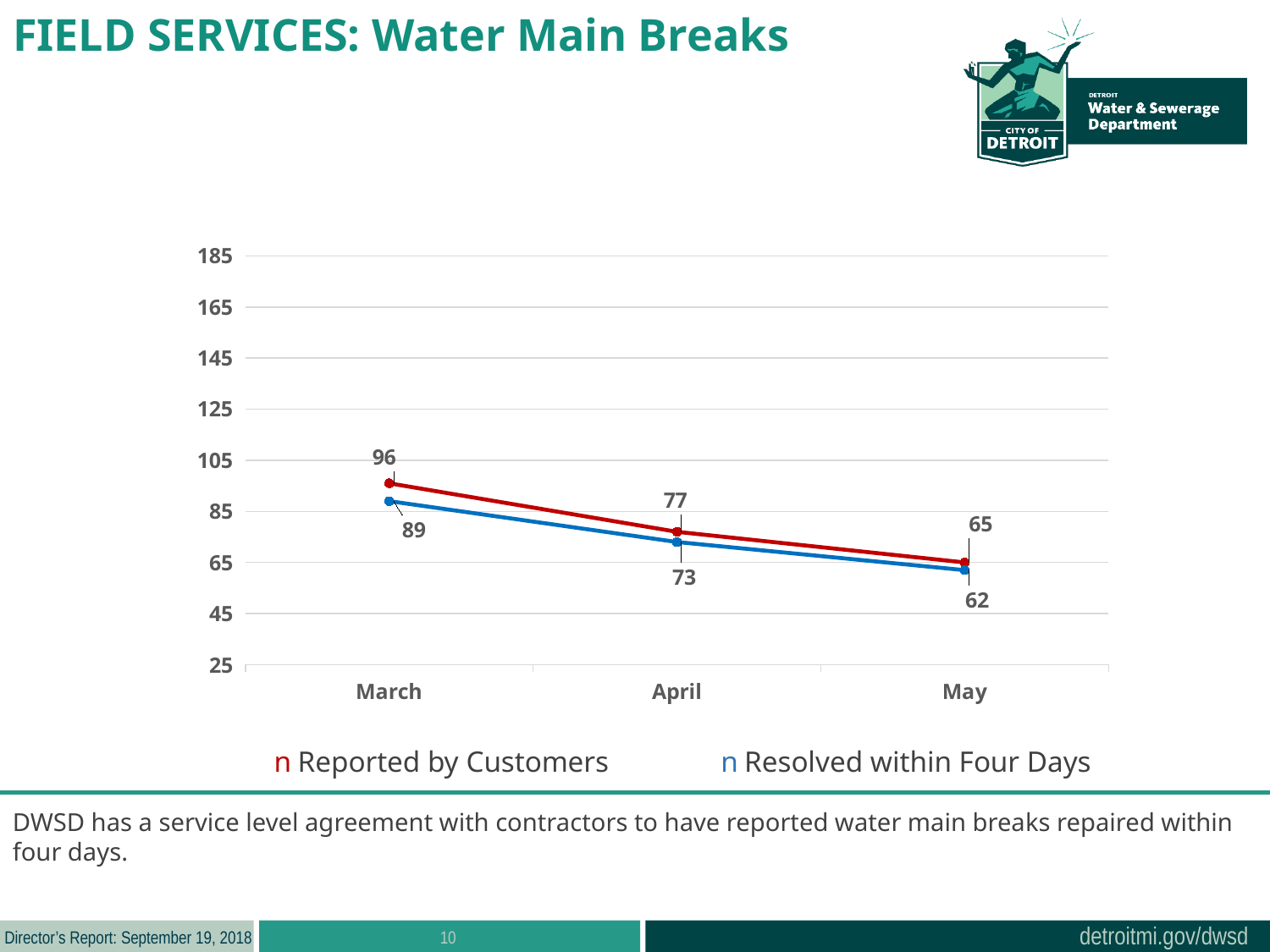
How many series does the legend list? 2 Do the Reported by Customers values rise or fall from March to May? Fall What is the value for Resolved within Four Days in April? 73 How many months are shown on the x axis? 3 What is the difference between Reported by Customers and Resolved within Four Days in April? 4 What is the value for Resolved within Four Days in March? 89 What kind of chart is shown on the slide? Line chart Which is larger in May: Reported by Customers or Resolved within Four Days? Reported by Customers In which month is the Resolved within Four Days value lowest? May What is the value for Reported by Customers in March? 96 What is the value for Reported by Customers in May? 65 In which month is the Reported by Customers value highest? March